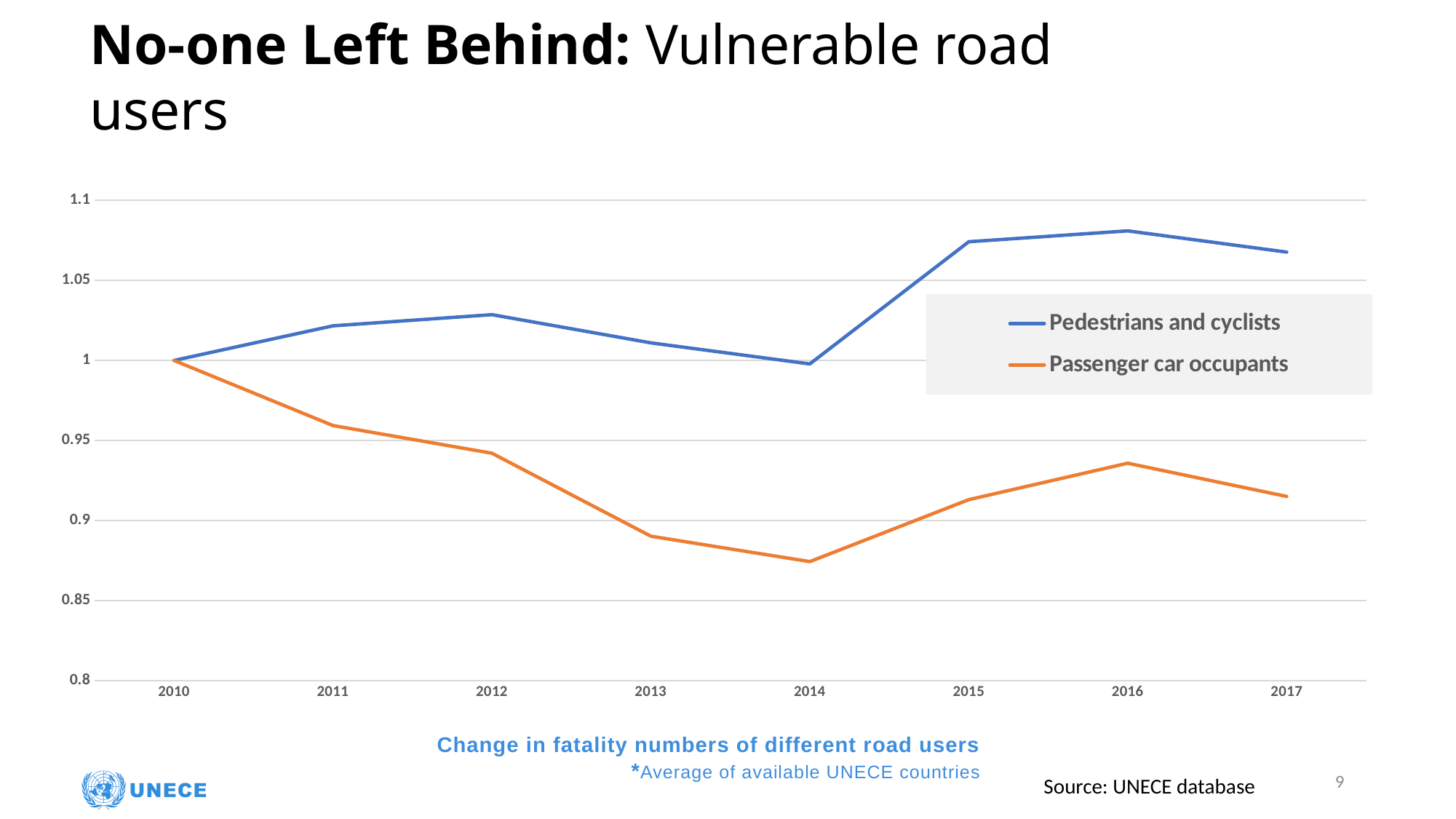
In which year is the value for Passenger car occupants lowest? 2014 How many years are plotted along the x axis? 8 Is the value for Passenger car occupants in 2011 greater or less than 0.95? greater Is the value for Pedestrians and cyclists in 2016 greater or less than 1.05? greater What kind of chart is shown on the slide? line chart Do the values for Passenger car occupants rise or fall from 2010 to 2014? fall How many series does the legend list? 2 What is the value for Pedestrians and cyclists in 2010? 1 What is the value for Passenger car occupants in 2010? 1 What is the title of the chart? Change in fatality numbers of different road users Is the value for Passenger car occupants in 2014 greater or less than 0.9? less In 2017, which series has the higher value, Pedestrians and cyclists or Passenger car occupants? Pedestrians and cyclists